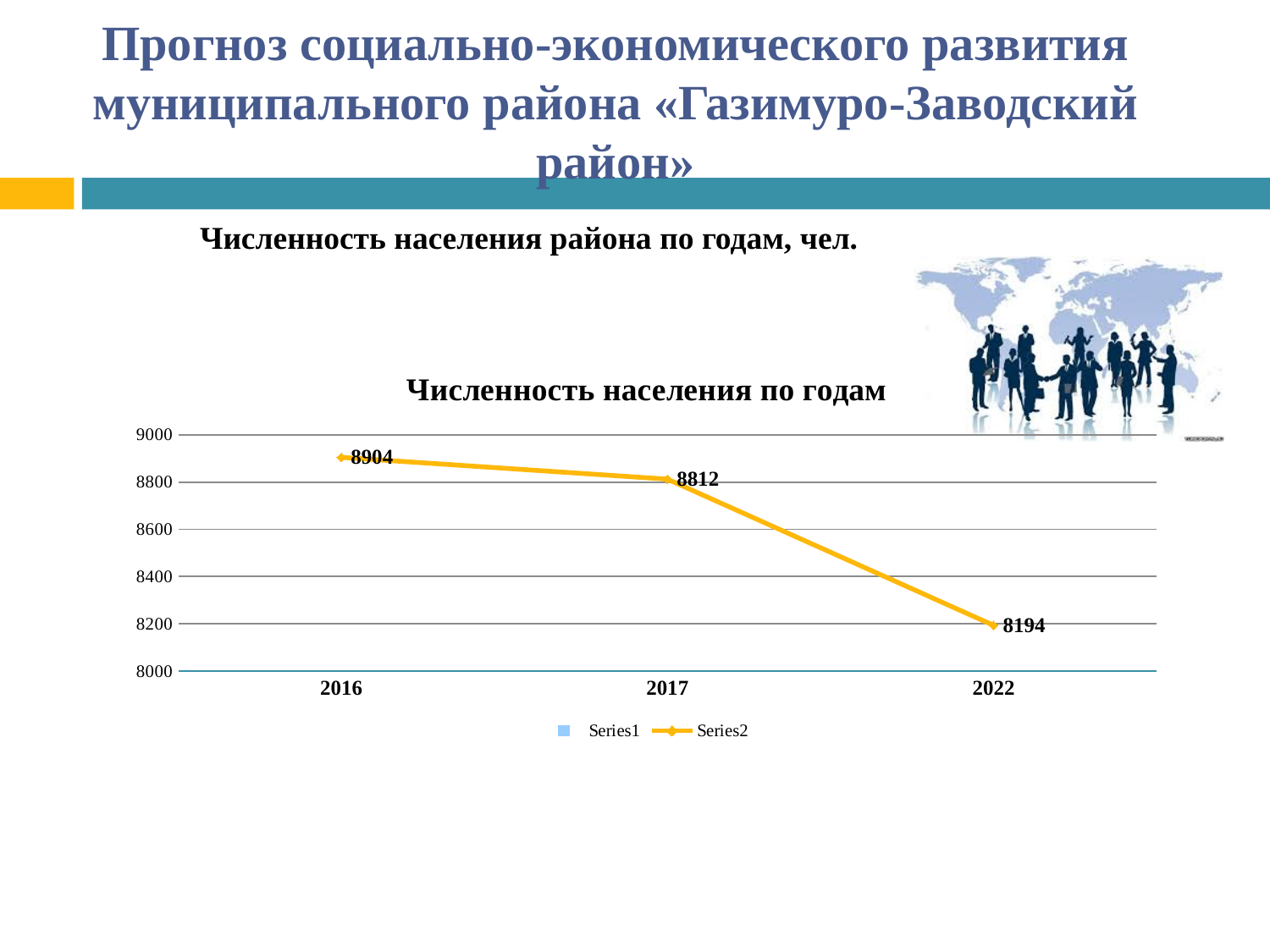
Is the value for 2022 greater or less than 8400? less What is the difference between the population values for 2017 and 2022? 618 How many years are plotted on the chart? 3 What is the population value shown for 2022? 8194 What is the population value shown for 2017? 8812 Which is larger, the population value for 2016 or for 2017? 2016 Which year has the highest population value? 2016 What is the population value shown for 2016? 8904 Which year has the lowest population value? 2022 What is the difference between the population values for 2016 and 2022? 710 What kind of chart is shown? line chart Do the population values rise or fall from 2016 to 2022? fall